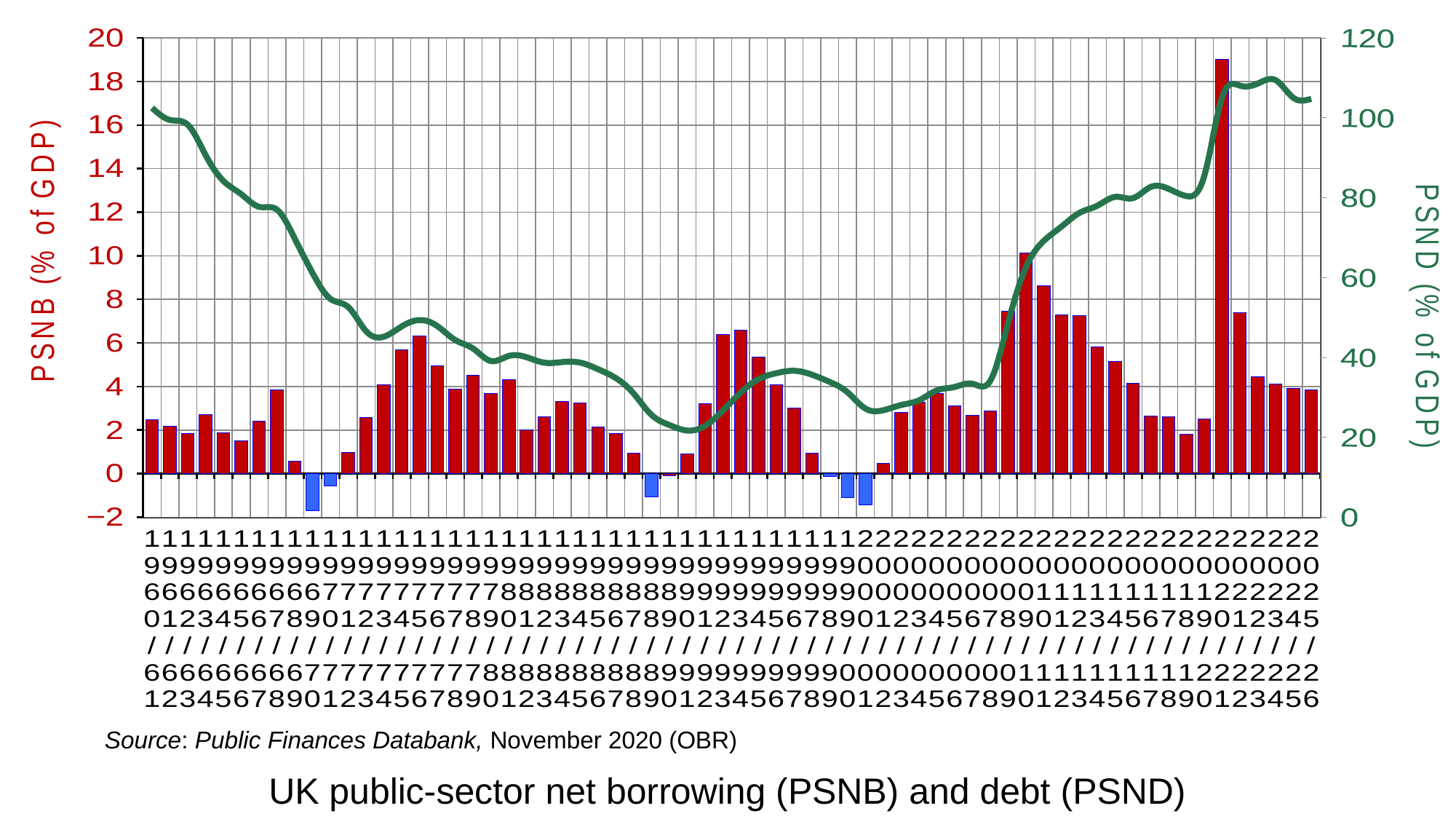
What is the title of the chart? UK public-sector net borrowing (PSNB) and debt (PSND) Is the PSNB value for 2009/10 greater or less than 8? greater Is the PSNB value for 2020/21 greater or less than 18? greater Does the PSND line rise or fall between 1960/61 and 1990/91? fall Is the PSND value for 1990/91 greater or less than 40? less Which fiscal year has the highest PSNB bar? 2020/21 Which is larger, the PSNB value for 2009/10 or for 1993/94? 2009/10 What kind of chart is shown on the slide? A combined bar and line chart What is the label of the right-hand vertical axis? PSND (% of GDP) How many fiscal years are plotted on the x axis? 66